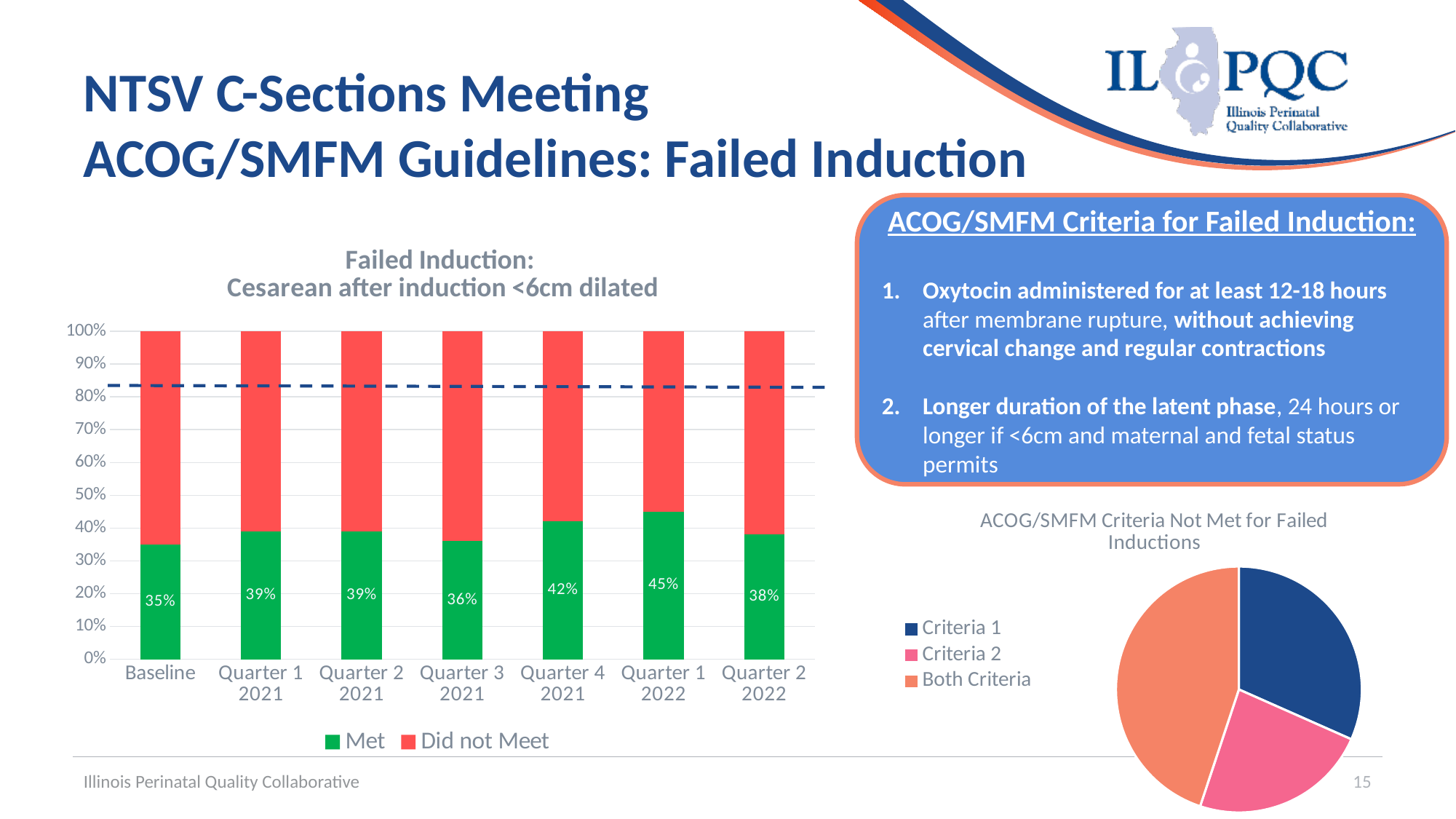
In the 'Failed Induction: Cesarean after induction <6cm dilated' chart, what is the Met value for Quarter 3 2021? 36% How many categories does the legend of the 'ACOG/SMFM Criteria Not Met for Failed Inductions' pie chart list? 3 In the 'Failed Induction: Cesarean after induction <6cm dilated' chart, which period has the highest Met value? Quarter 1 2022 In the 'Failed Induction: Cesarean after induction <6cm dilated' chart, which period has the lowest Met value? Baseline What kind of chart is the 'Failed Induction: Cesarean after induction <6cm dilated' chart? Stacked bar chart In the 'Failed Induction: Cesarean after induction <6cm dilated' chart, what is the Met value for Baseline? 35% In the 'ACOG/SMFM Criteria Not Met for Failed Inductions' pie chart, which category has the largest slice? Both Criteria In the 'Failed Induction: Cesarean after induction <6cm dilated' chart, which has a larger Met value, Quarter 4 2021 or Quarter 3 2021? Quarter 4 2021 How many periods are shown on the x axis of the 'Failed Induction: Cesarean after induction <6cm dilated' chart? 7 In the 'Failed Induction: Cesarean after induction <6cm dilated' chart, what is the Met value for Quarter 1 2022? 45% In the 'Failed Induction: Cesarean after induction <6cm dilated' chart, what is the difference between the Met value for Quarter 1 2022 and the Met value for Baseline? 10 percentage points How many series does the legend of the 'Failed Induction: Cesarean after induction <6cm dilated' chart list? 2